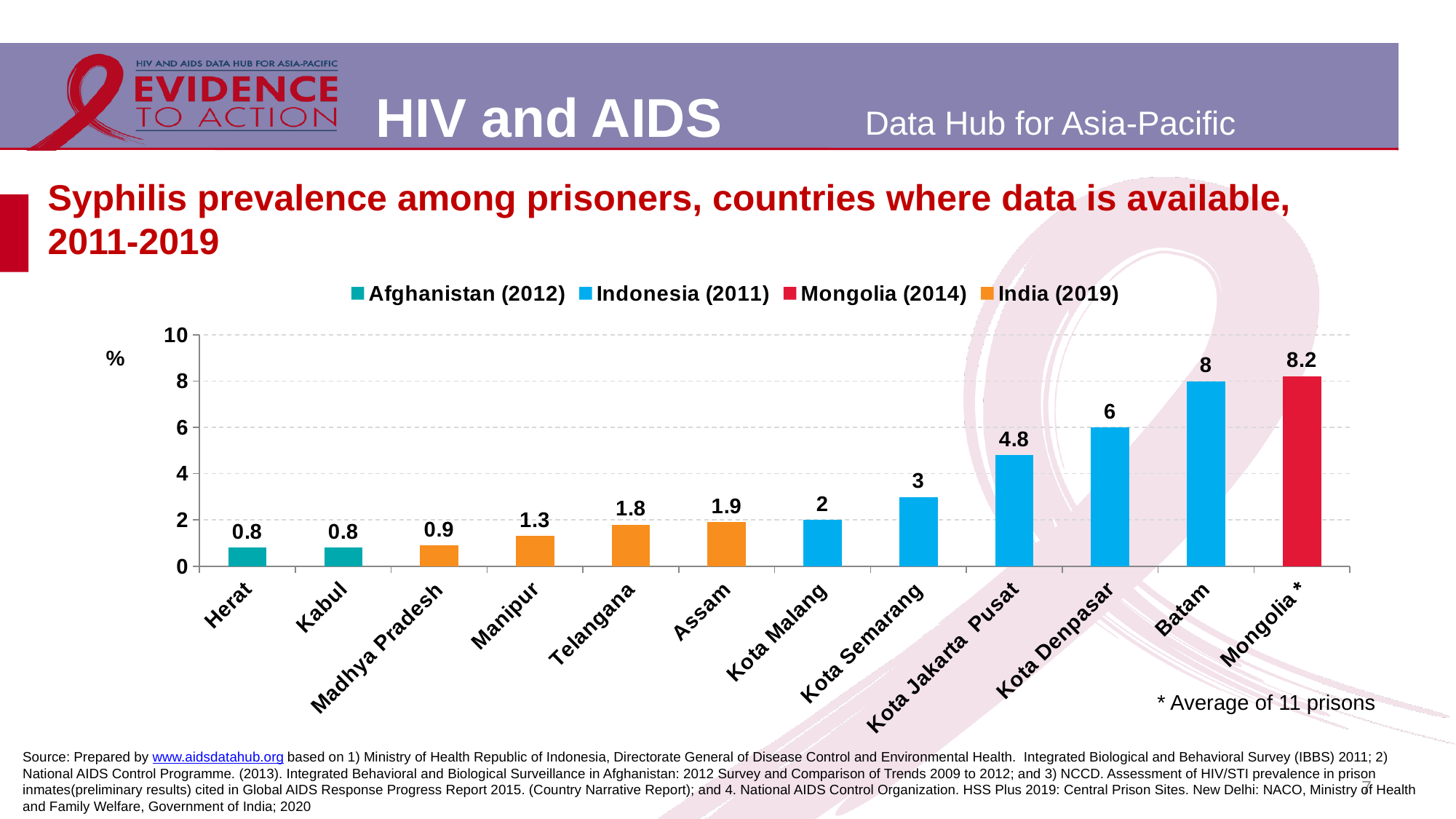
Which has a larger value, Assam or Manipur? Assam What is the value shown for Batam? 8 What kind of chart is shown on the slide? Bar chart How many series does the legend list? 4 What is the value shown for Telangana? 1.8 What is the difference between the values for Kota Denpasar and Kota Semarang? 3 How many categories (bars) are shown on the x axis? 12 Which category has the highest value on the chart? Mongolia * What is the syphilis prevalence value shown for Kota Jakarta Pusat? 4.8 Is the value for Kota Denpasar greater or less than 4? greater Do the values generally rise or fall moving from left to right along the x axis? Rise Which legend series is shown in red? Mongolia (2014)